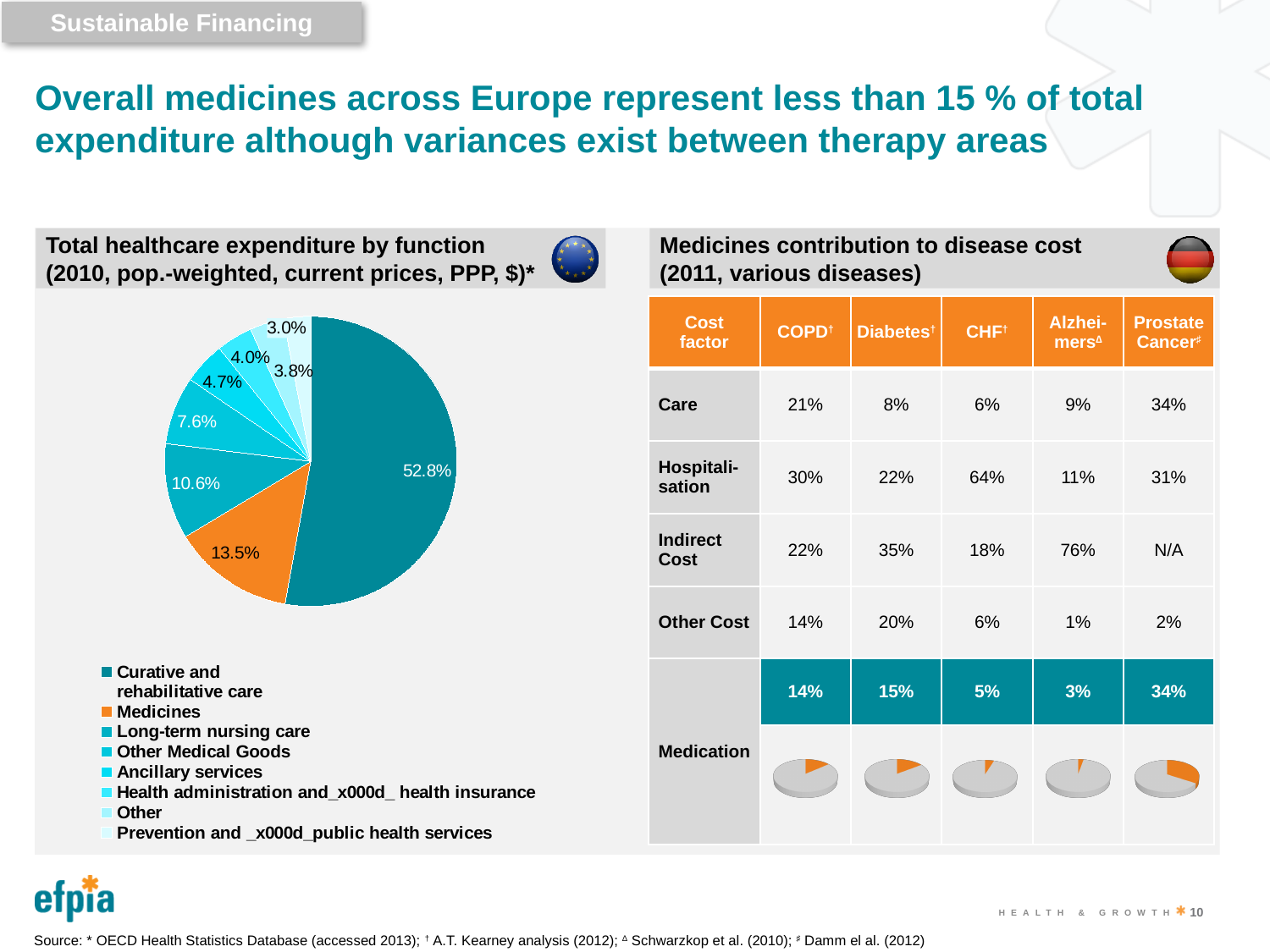
In the 'Total healthcare expenditure by function' pie chart, how many percentage points larger is Curative and rehabilitative care than Medicines? 39.3 percentage points In the 'Total healthcare expenditure by function' pie chart, which is larger: Long-term nursing care or Other Medical Goods? Long-term nursing care What kind of chart is shown under the title 'Total healthcare expenditure by function'? Pie chart How many slices does the 'Total healthcare expenditure by function' pie chart have? 8 In the 'Total healthcare expenditure by function' pie chart, what share is Medicines? 13.5% In the 'Medicines contribution to disease cost' panel, what is the Medication share for Prostate Cancer? 34% In the 'Medicines contribution to disease cost' panel, which disease has the lowest Medication share? Alzheimers In the 'Total healthcare expenditure by function' pie chart, what share is Ancillary services? 4.7% In the 'Total healthcare expenditure by function' pie chart, what share is Curative and rehabilitative care? 52.8% In the 'Total healthcare expenditure by function' pie chart, which category has the largest slice? Curative and rehabilitative care In the 'Total healthcare expenditure by function' pie chart, what colour is the Medicines slice? Orange In the 'Total healthcare expenditure by function' pie chart, what share is Long-term nursing care? 10.6%